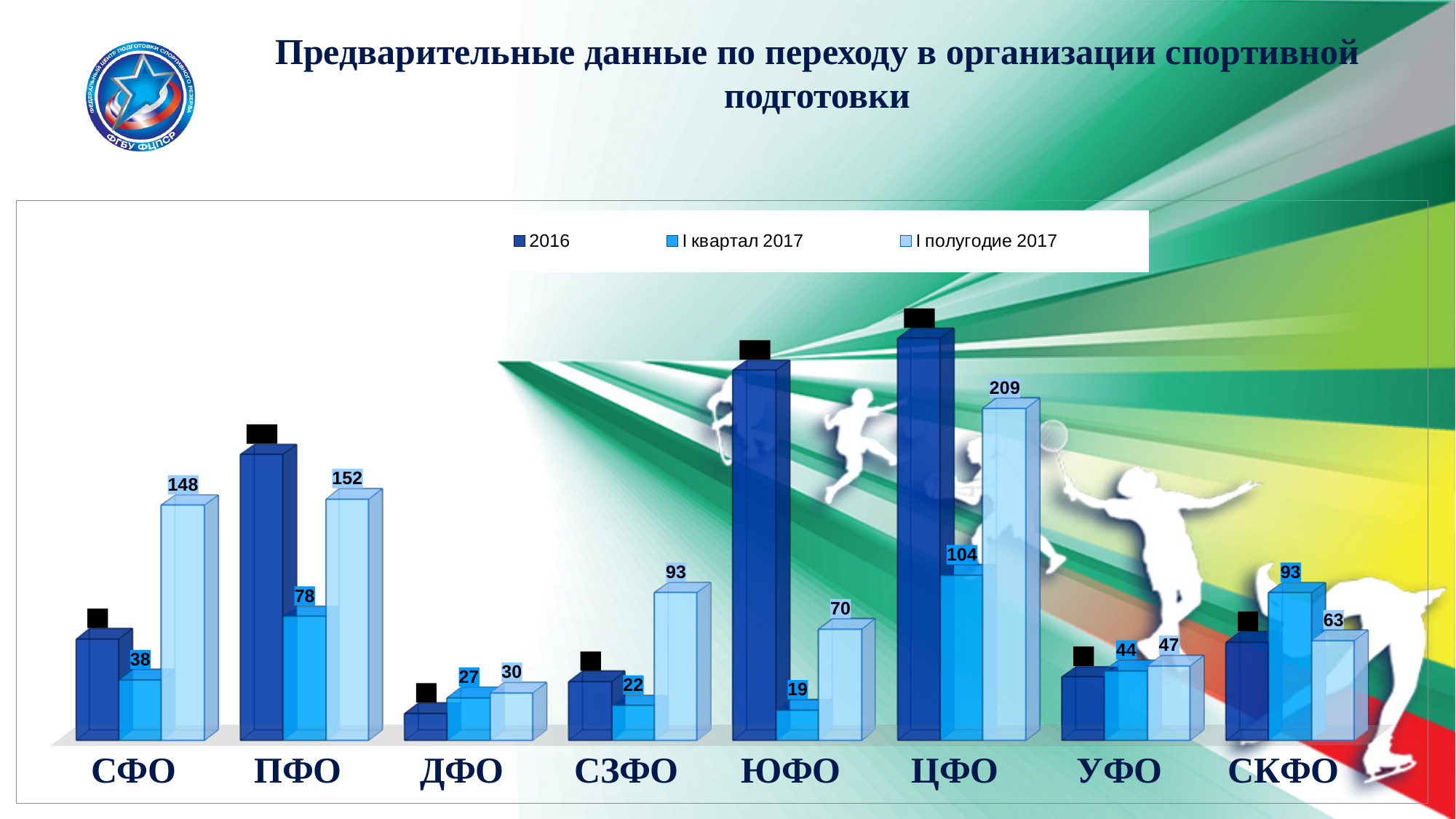
Which category has the highest value in the I полугодие 2017 series? ЦФО What kind of chart is shown on the slide? bar chart How many series does the legend list? 3 Which is larger for СКФО: the I квартал 2017 value or the I полугодие 2017 value? I квартал 2017 Which series is shown in the darkest blue colour according to the legend? 2016 What is the value for СКФО in the I полугодие 2017 series? 63 How many categories (federal districts) are shown on the x axis? 8 What is the value for ЦФО in the I полугодие 2017 series? 209 What is the value for ПФО in the I квартал 2017 series? 78 What is the difference between the I полугодие 2017 values for ПФО and СФО? 4 What is the difference between the I полугодие 2017 and I квартал 2017 values for ЦФО? 105 Which category has the lowest value in the I квартал 2017 series? ЮФО